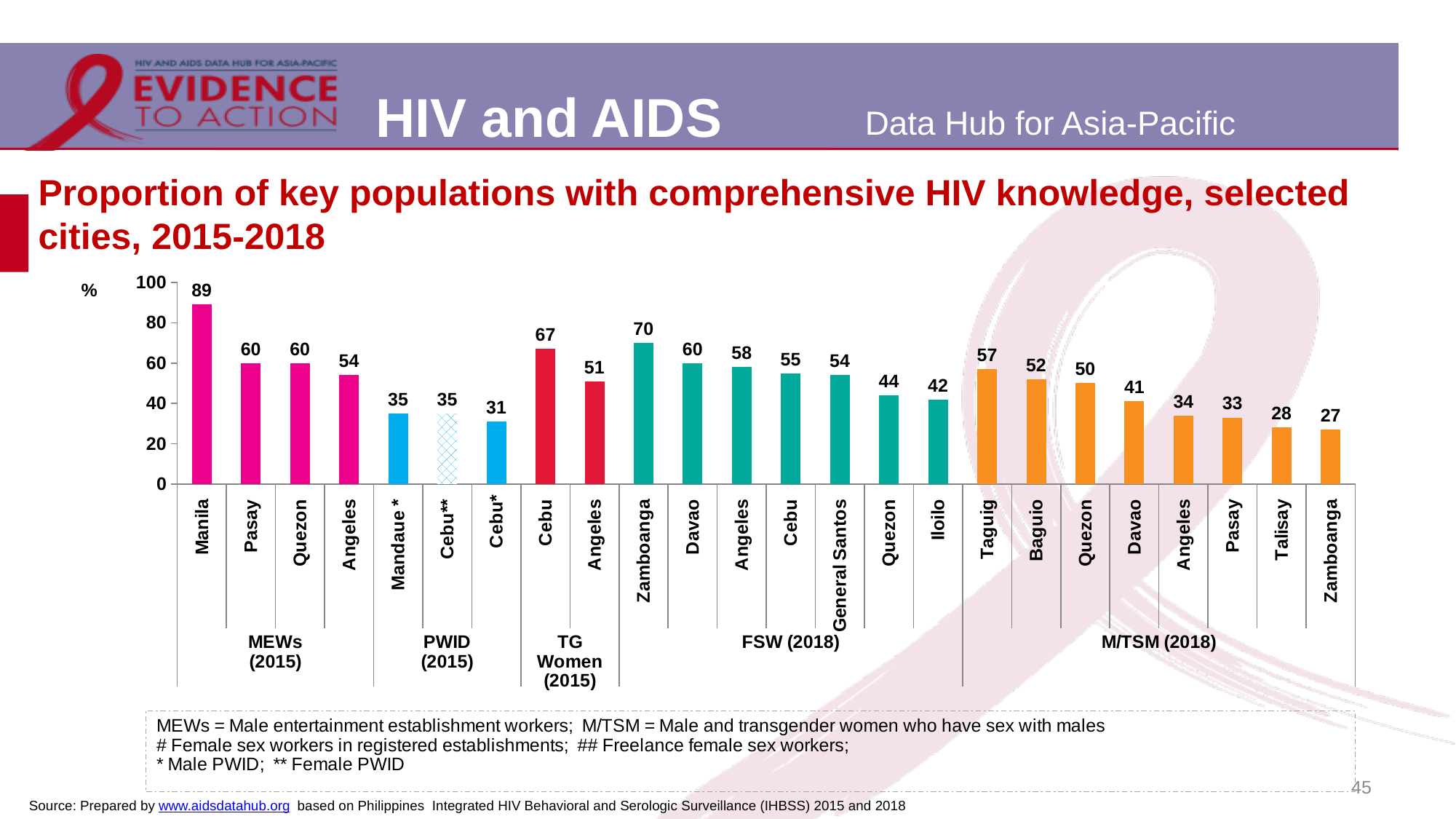
What is the value for Talisay in the M/TSM (2018) group? 28 Which is larger: Cebu in the TG Women (2015) group or Cebu in the FSW (2018) group? Cebu in TG Women (2015) What kind of chart is shown on the slide? Bar chart Do the values in the M/TSM (2018) group rise or fall from Taguig to Zamboanga? Fall How many bars are plotted in the FSW (2018) group? 7 What is the difference between Taguig and Baguio in the M/TSM (2018) group? 5 What is the value for Zamboanga in the FSW (2018) group? 70 Is the value for Iloilo in the FSW (2018) group greater or less than 60? less What is the value for Cebu in the TG Women (2015) group? 67 What is the value for Manila in the MEWs (2015) group? 89 Which city has the lowest value on the chart? Zamboanga (M/TSM 2018) Which city has the highest value on the chart? Manila